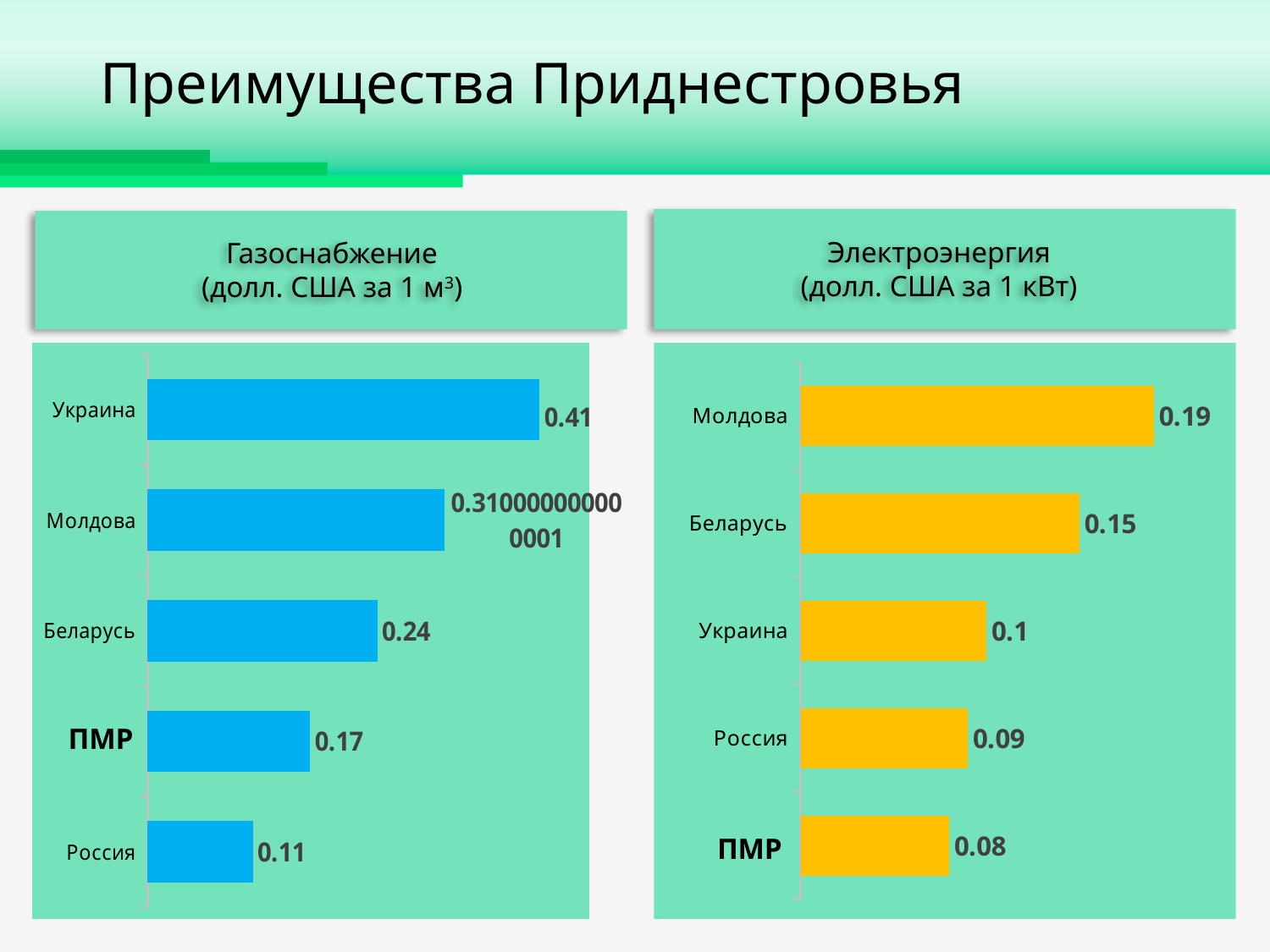
In the Электроэнергия chart, what is the value for Молдова? 0.19 In the Газоснабжение chart, which category has the lowest value? Россия In the Электроэнергия chart, which category has the lowest value? ПМР In the Газоснабжение chart, what is the value for Украина? 0.41 In the Газоснабжение chart, how many categories are shown? 5 In the Электроэнергия chart, what is the difference between the values for Молдова and ПМР? 0.11 In the Газоснабжение chart, what is the value for ПМР? 0.17 In the Электроэнергия chart, what is the value for ПМР? 0.08 In the Газоснабжение chart, what is the difference between the values for Украина and Россия? 0.3 What type of chart is the Электроэнергия chart? Bar chart In the Электроэнергия chart, which is larger, the value for Беларусь or the value for Украина? Беларусь In the Газоснабжение chart, which category has the highest value? Украина